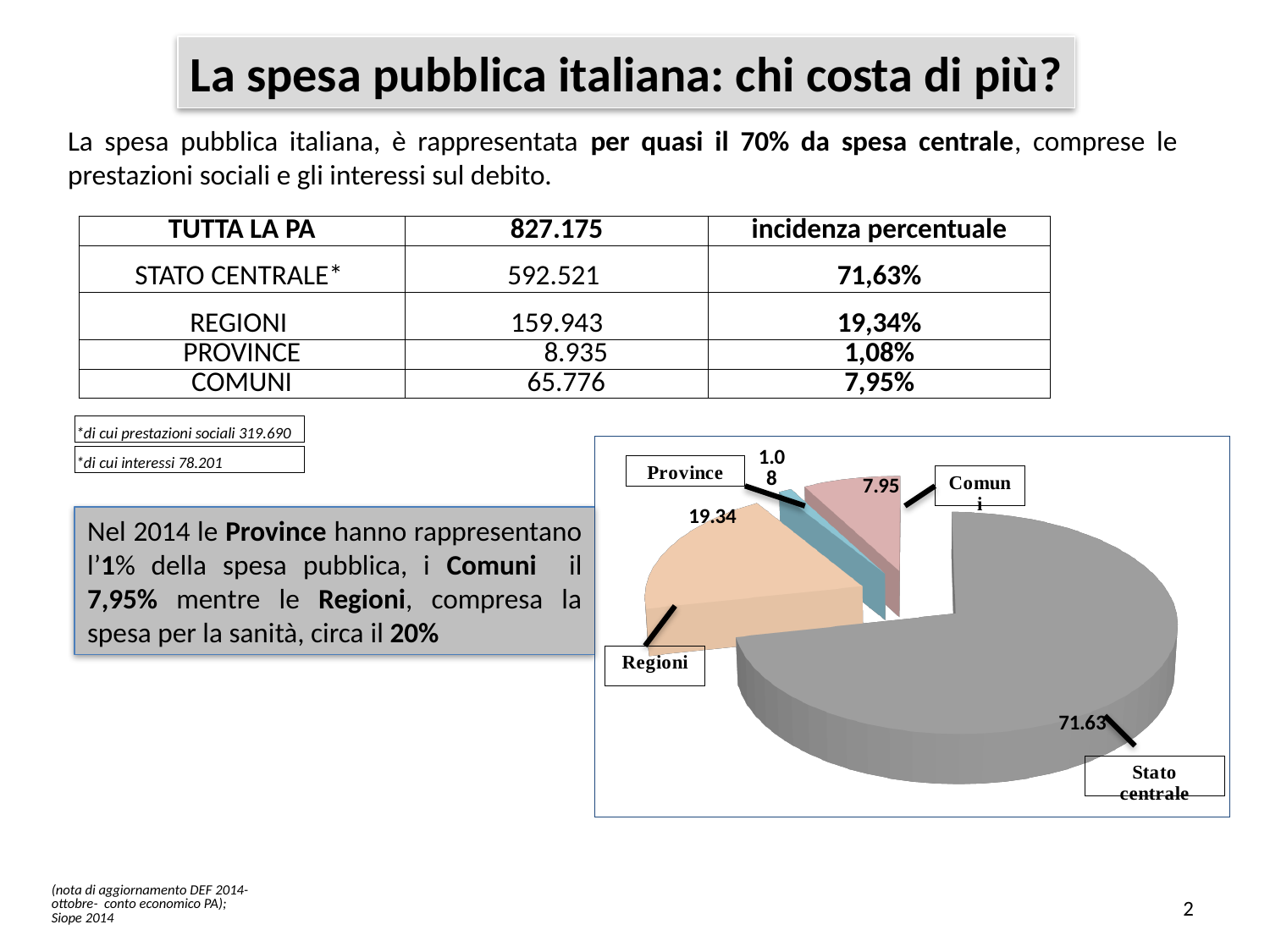
Which slice of the pie chart is the smallest? Province What is the difference between the values for Comuni and Province in the pie chart? 6.87 What kind of chart is shown on the slide? pie chart What value is shown for Comuni in the pie chart? 7.95 What share of the pie does the Stato centrale slice represent? 71.63 How many slices does the pie chart have? 4 What value is shown for Stato centrale in the pie chart? 71.63 In the pie chart, which is larger, Regioni or Comuni? Regioni What is the difference between the values for Stato centrale and Regioni in the pie chart? 52.29 What value is shown for Province in the pie chart? 1.08 Which slice of the pie chart is the largest? Stato centrale What value is shown for Regioni in the pie chart? 19.34